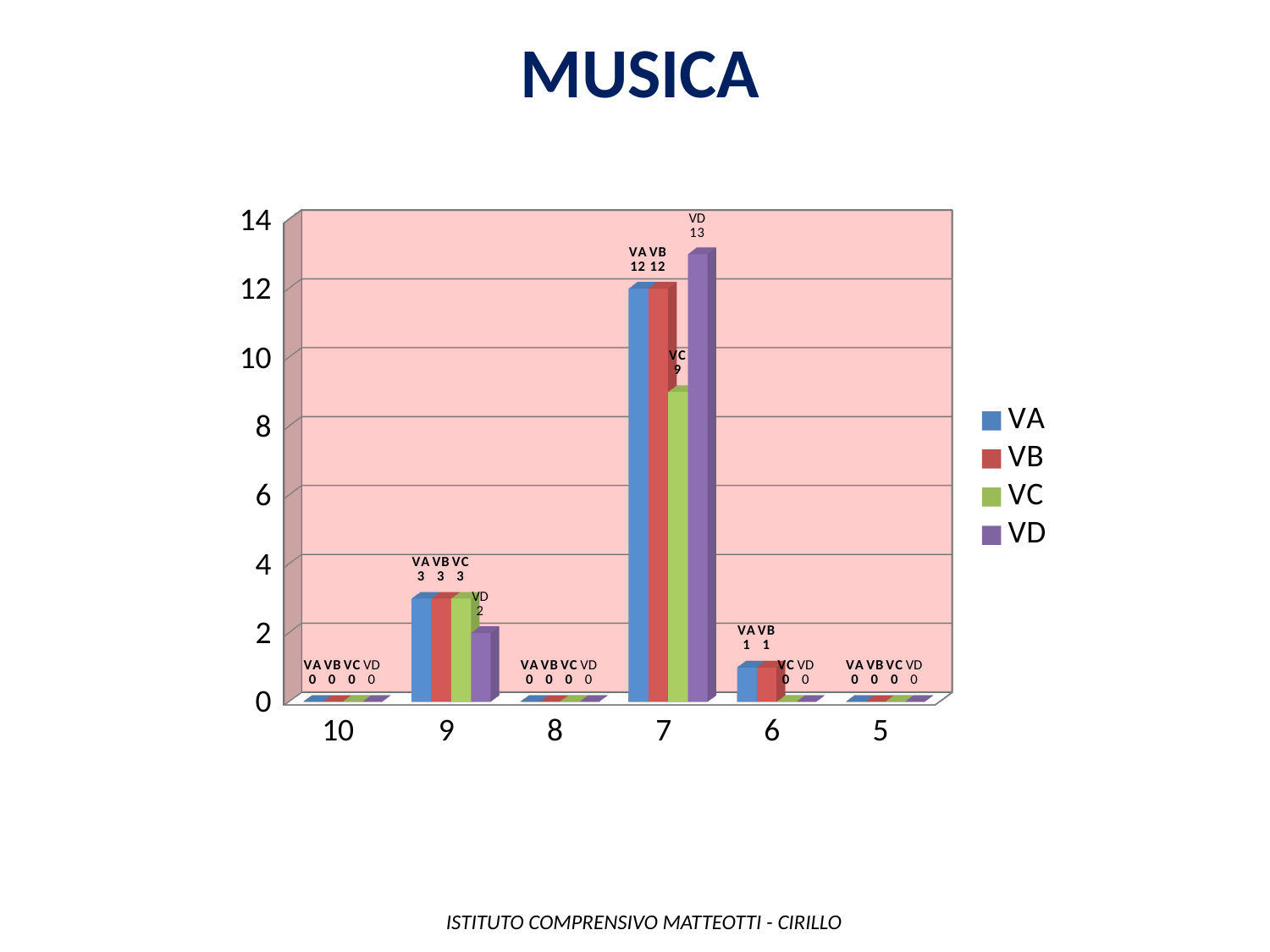
What is the difference between the VD value and the VC value at category 7? 4 How many series does the legend list? 4 Which series has the lowest value at category 9? VD What kind of chart is shown on the slide? bar chart What is the value for VA at category 6? 1 Which series has the highest value at category 7? VD How many categories are shown on the x axis? 6 What is the value for VD at category 7? 13 What is the value for VD at category 9? 2 What is the value for VC at category 7? 9 What is the title of the chart? MUSICA Which is larger at category 7: the value for VA or the value for VC? VA